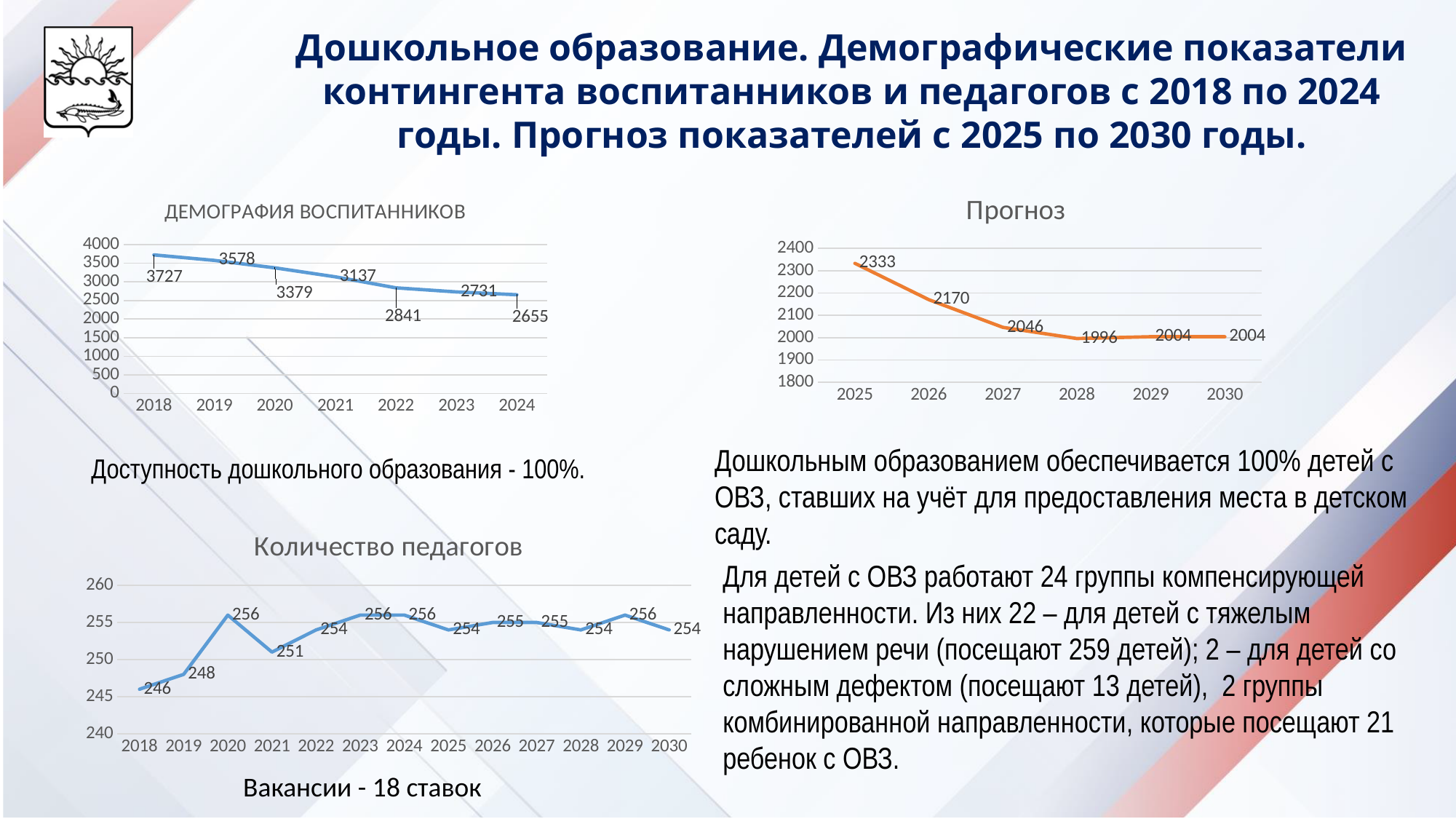
In the chart titled 'Прогноз', what is the difference between the 2025 and 2026 values? 163 In the chart titled 'Прогноз', which year has the lowest value? 2028 In the chart titled 'Количество педагогов', is the value for 2021 larger or smaller than the value for 2020? smaller In the chart titled 'ДЕМОГРАФИЯ ВОСПИТАННИКОВ', how many years are plotted? 7 In the chart titled 'ДЕМОГРАФИЯ ВОСПИТАННИКОВ', what is the difference between the 2018 and 2024 values? 1072 In the chart titled 'Количество педагогов', what is the value for 2018? 246 In the chart titled 'Количество педагогов', which year has the lowest value? 2018 In the chart titled 'ДЕМОГРАФИЯ ВОСПИТАННИКОВ', do the values rise or fall from 2018 to 2024? fall In the chart titled 'ДЕМОГРАФИЯ ВОСПИТАННИКОВ', what is the value for 2018? 3727 In the chart titled 'ДЕМОГРАФИЯ ВОСПИТАННИКОВ', what is the value for 2024? 2655 What type of chart is the chart titled 'Прогноз'? line chart In the chart titled 'Прогноз', what is the value for 2025? 2333